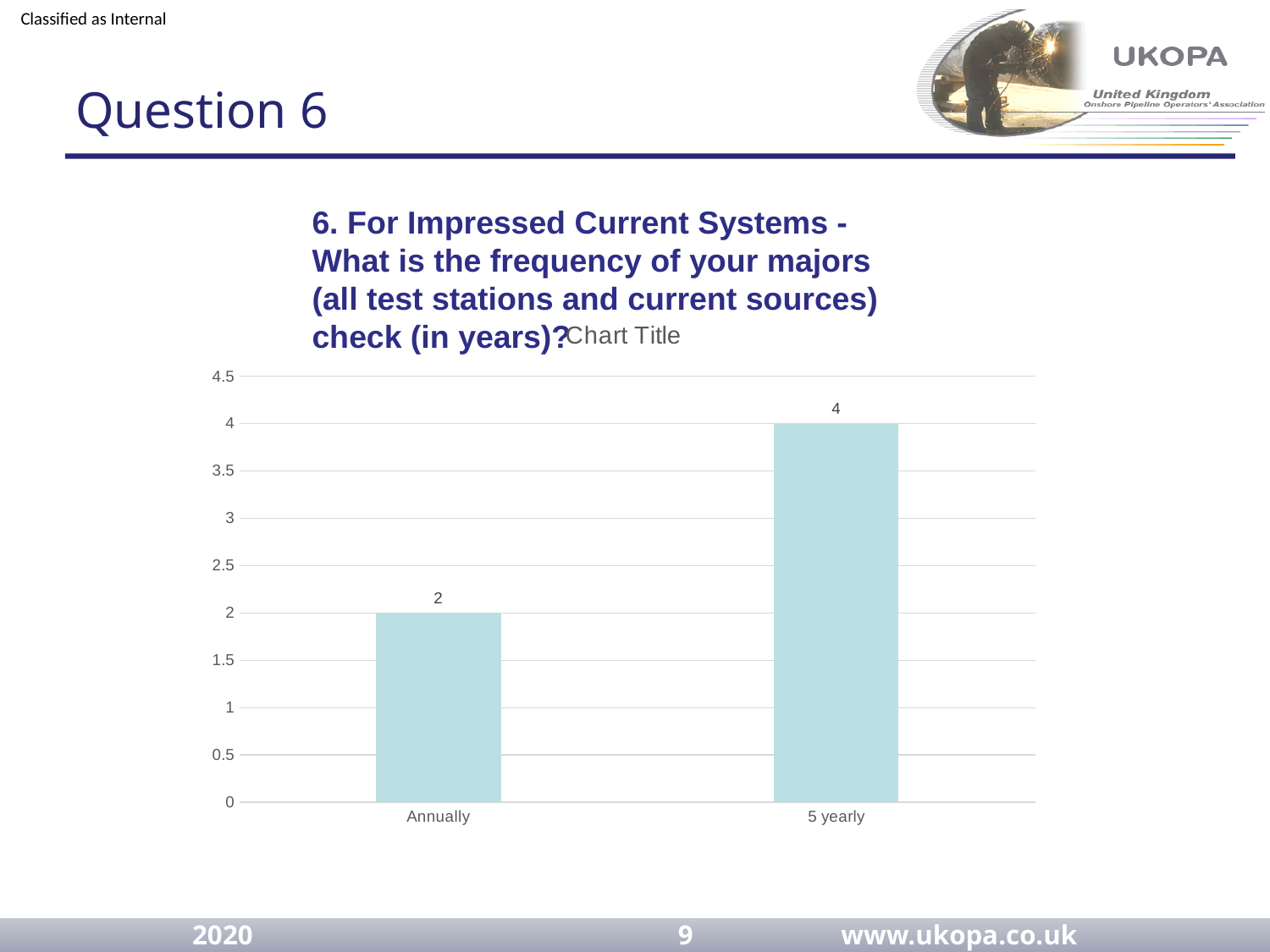
Is the value for Annually greater or less than 3? less What kind of chart is shown on the slide? bar chart How many categories are shown on the x axis? 2 What is the highest value shown on the vertical axis? 4.5 Which category has the lowest value? Annually What is the value for Annually? 2 What is the value for 5 yearly? 4 Is the value for 5 yearly greater or less than 3? greater Which category has the highest value? 5 yearly Which is larger, the value for Annually or the value for 5 yearly? 5 yearly What is the total of the two bars shown? 6 What is the difference between the values for 5 yearly and Annually? 2